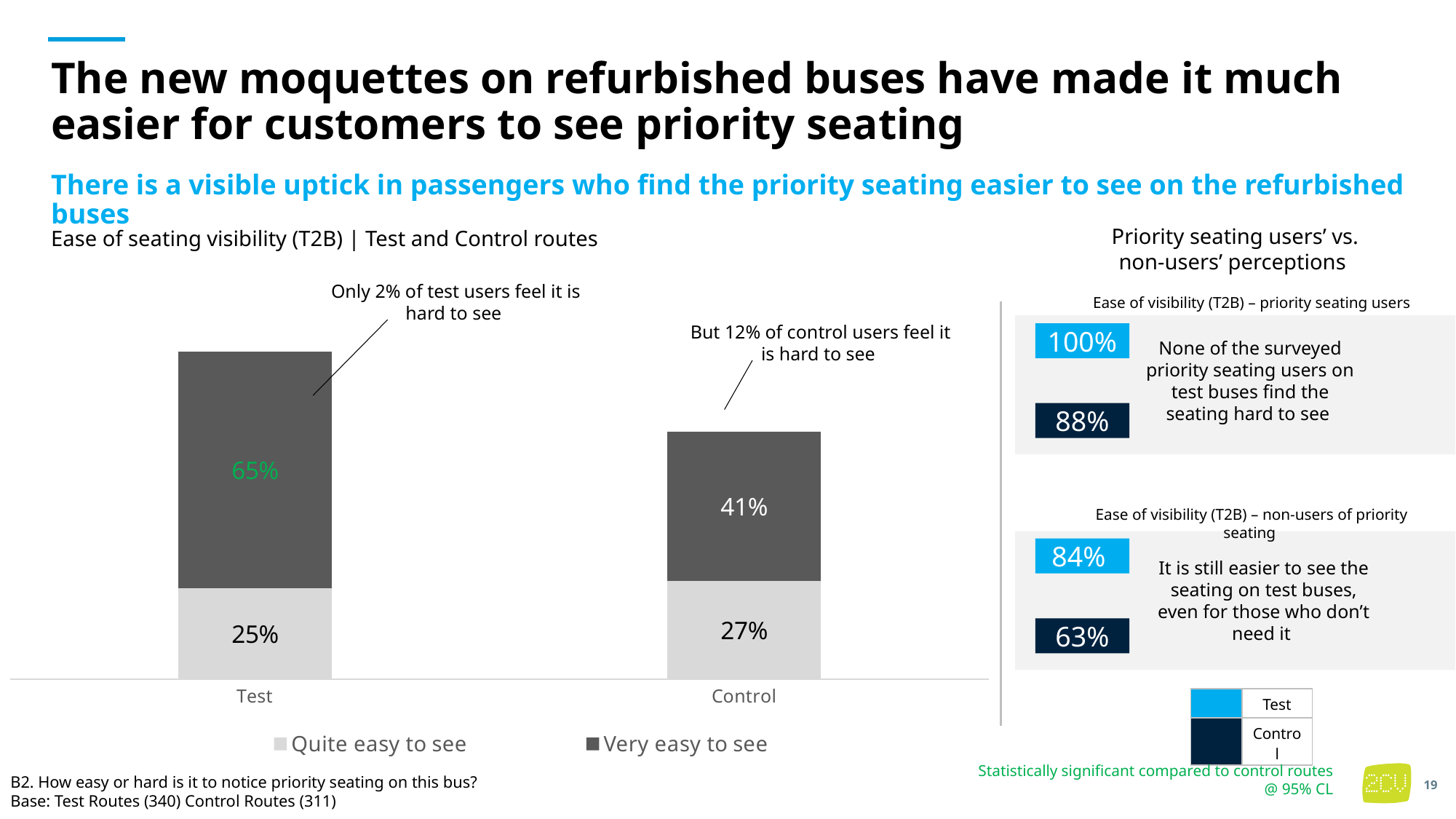
In the ease of seating visibility chart, which route has the higher 'Very easy to see' value, Test or Control? Test How many series does the legend of the ease of seating visibility chart list? 2 In the ease of seating visibility chart, what percentage of Control route passengers said the seating was 'Very easy to see'? 41% In the ease of seating visibility chart, what percentage of Test route passengers said the seating was 'Very easy to see'? 65% In the ease of seating visibility chart, what is the total (T2B) of the stacked bar for Test? 90% In the ease of seating visibility chart, which series is shown in dark grey? Very easy to see In the ease of seating visibility chart, what is the total (T2B) of the stacked bar for Control? 68% How many categories are shown on the x axis of the ease of seating visibility chart? 2 In the ease of seating visibility chart, what percentage of Test route passengers said the seating was 'Quite easy to see'? 25% In the ease of seating visibility chart, what percentage of Control route passengers said the seating was 'Quite easy to see'? 27% What type of chart is shown under 'Ease of seating visibility (T2B) | Test and Control routes'? Stacked bar chart In the ease of seating visibility chart, what is the difference between the 'Very easy to see' values for Test and Control? 24 percentage points